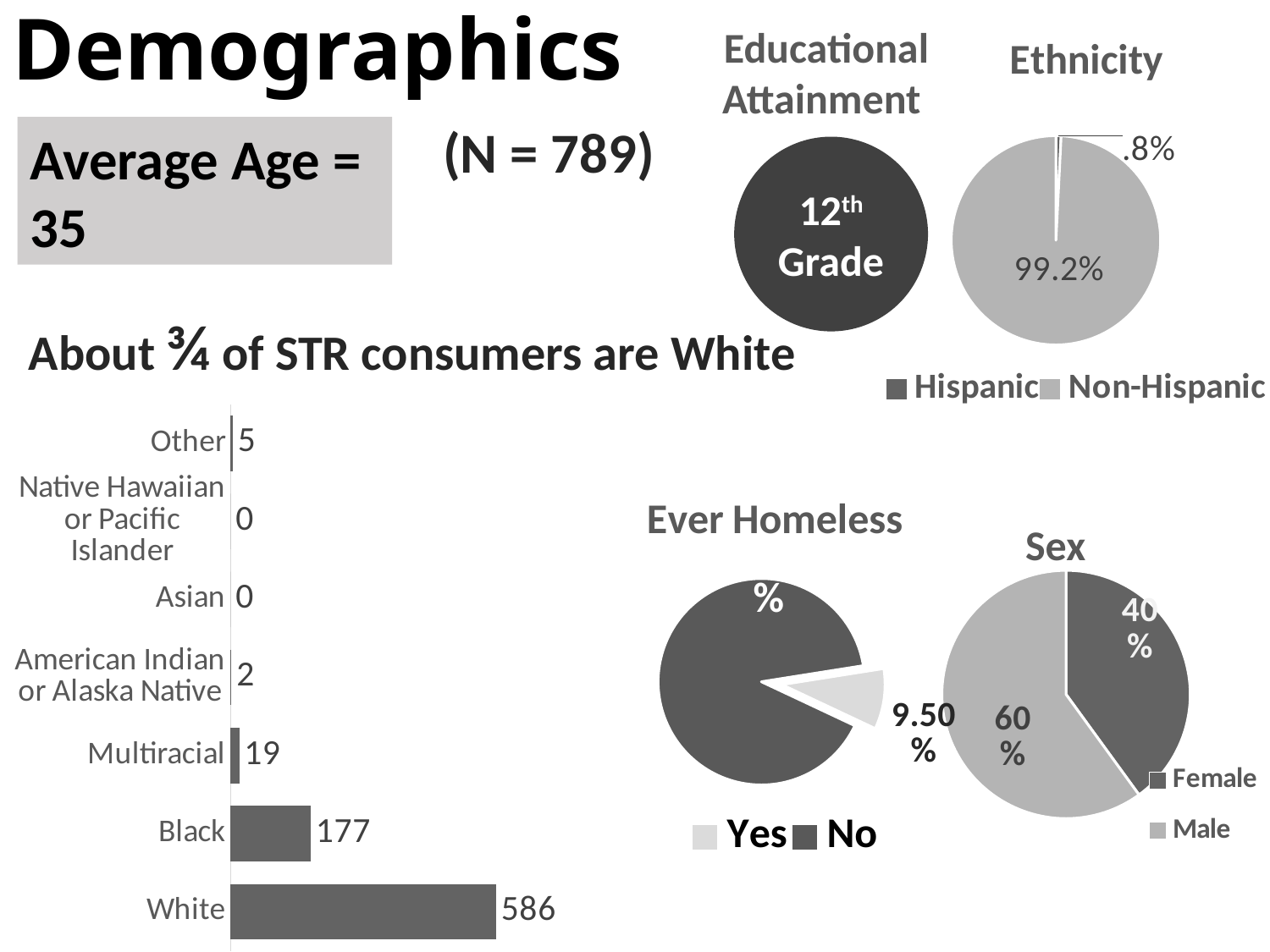
On the Ethnicity pie chart, what share is Non-Hispanic? 99.2% On the horizontal bar chart of race at the bottom left, which category has the highest value? White What kind of chart is used to show race at the bottom left of the slide? Bar chart On the horizontal bar chart of race at the bottom left, how many categories are shown? 7 On the Sex pie chart, what share is Male? 60% On the horizontal bar chart of race at the bottom left, what is the difference between the values for White and Black? 409 On the Ethnicity pie chart, what share is Hispanic? .8% On the horizontal bar chart of race at the bottom left, what is the value for Black? 177 On the horizontal bar chart of race at the bottom left, which is larger, the value for Multiracial or the value for Other? Multiracial On the horizontal bar chart of race at the bottom left, what is the value for White? 586 On the horizontal bar chart of race at the bottom left, what is the value for Multiracial? 19